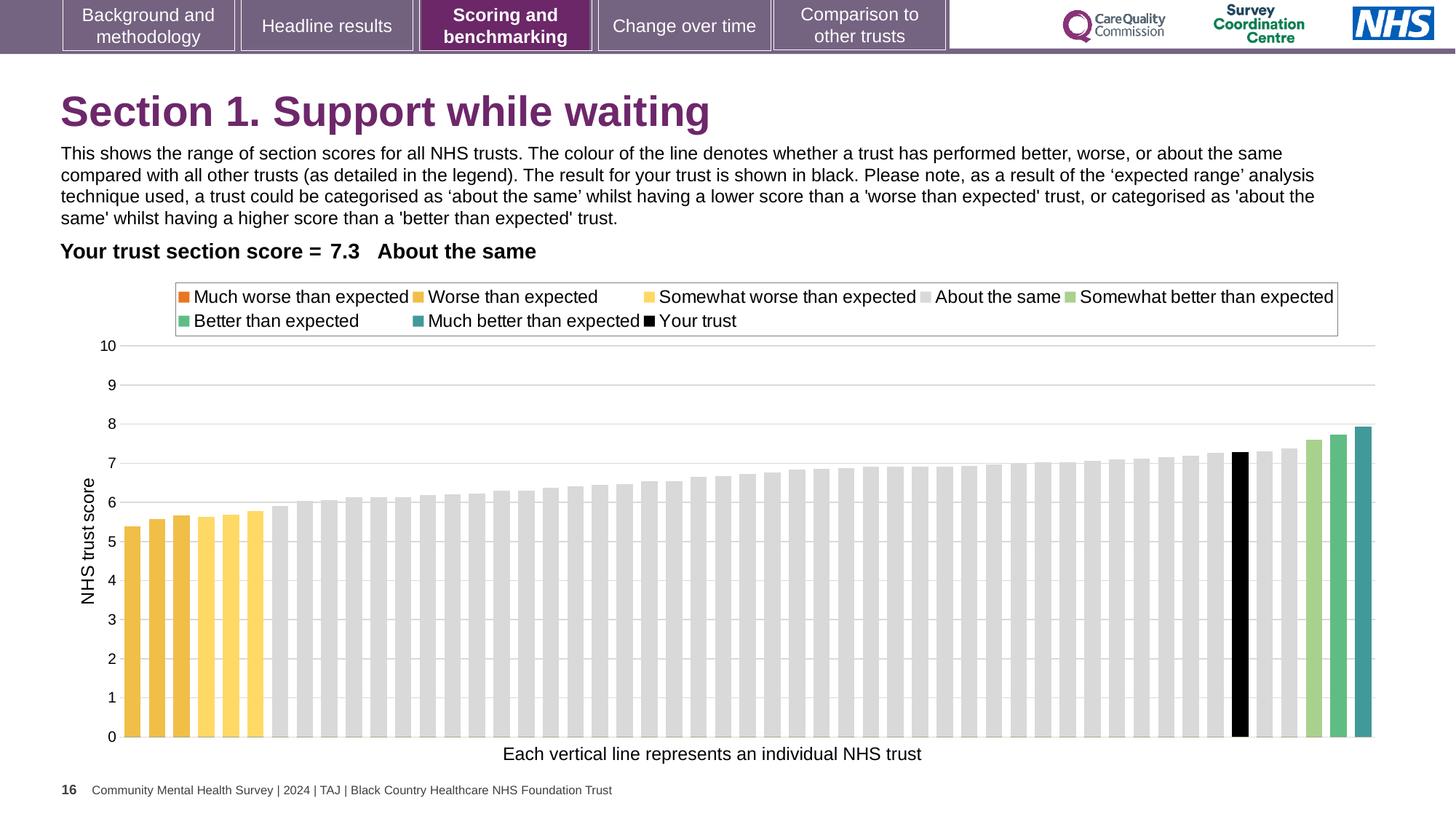
What is the label on the vertical axis of the chart? NHS trust score Do the bar values rise or fall from left to right along the x axis? Rise How many bars are coloured as 'Worse than expected'? 3 Is the value of the lowest bar greater or less than 6? less Which category is your trust placed in for this section? About the same Is the value of the highest bar greater or less than 7? greater How many bars are coloured as 'Much worse than expected'? 0 What kind of chart is shown on the slide? Bar chart How many bars are coloured as 'Much better than expected'? 1 How many entries does the chart legend list? 8 Which legend category does the tallest bar belong to? Much better than expected What is the section score for your trust shown on the slide? 7.3